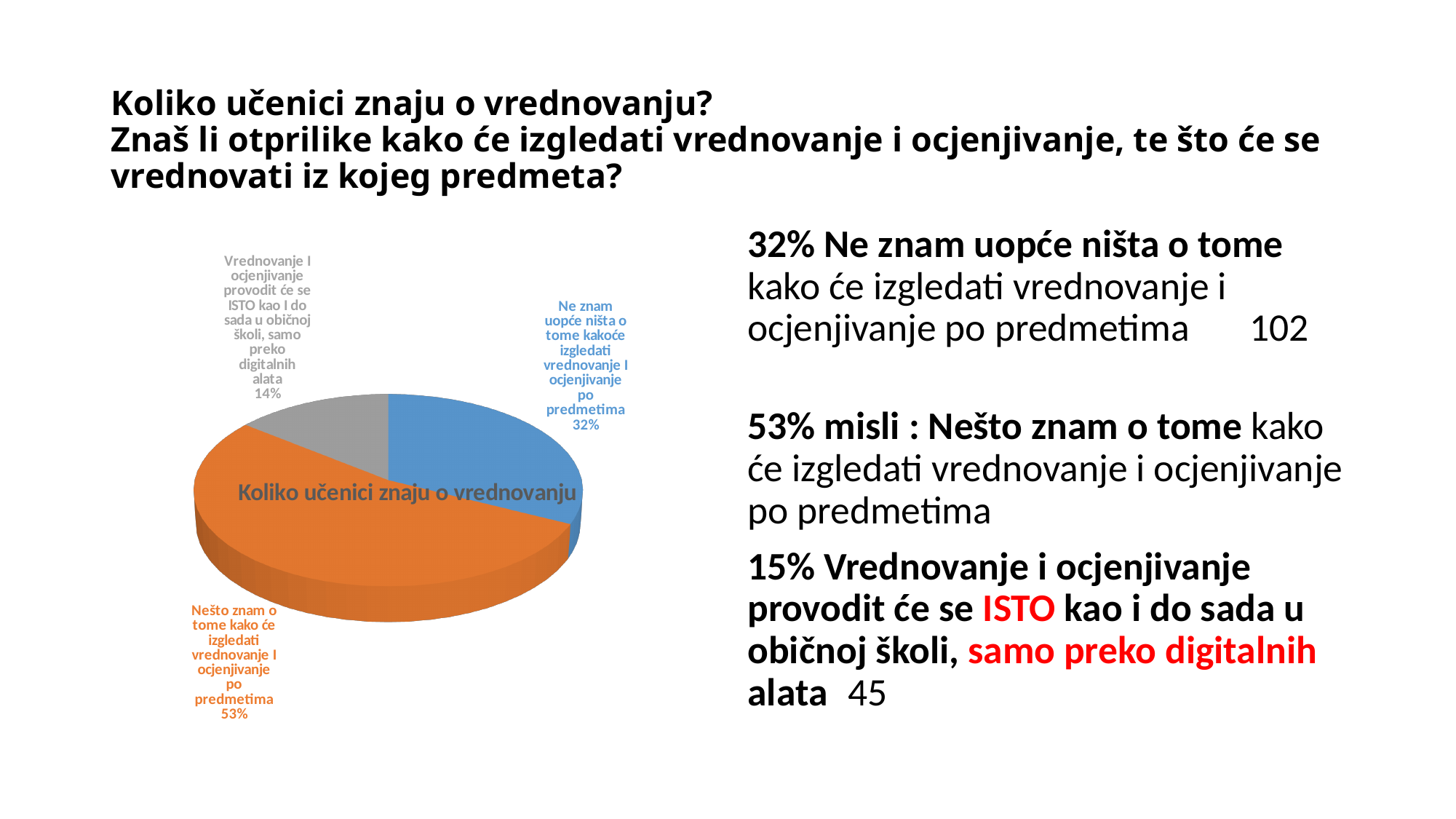
What is the title of the pie chart? Koliko učenici znaju o vrednovanju What share of the pie is labelled "Nešto znam o tome kako će izgledati vrednovanje I ocjenjivanje po predmetima"? 53% What share of the pie is labelled "Vrednovanje I ocjenjivanje provodit će se ISTO kao I do sada u običnoj školi, samo preko digitalnih alata"? 14% What colour is the slice labelled 53% in the pie chart? orange What kind of chart is shown on the slide? pie chart What share of the pie is labelled "Ne znam uopće ništa o tome kako će izgledati vrednovanje I ocjenjivanje po predmetima"? 32% What is the difference in percentage points between the "Ne znam uopće ništa" slice and the "Vrednovanje I ocjenjivanje provodit će se ISTO" slice? 18 Which slice of the pie chart is the smallest? Vrednovanje I ocjenjivanje provodit će se ISTO kao I do sada u običnoj školi, samo preko digitalnih alata Which is larger in the pie chart: the "Ne znam uopće ništa" slice or the "Vrednovanje I ocjenjivanje provodit će se ISTO" slice? Ne znam uopće ništa o tome kako će izgledati vrednovanje I ocjenjivanje po predmetima Which slice of the pie chart is the largest? Nešto znam o tome kako će izgledati vrednovanje I ocjenjivanje po predmetima How many slices does the pie chart have? 3 What is the difference in percentage points between the "Nešto znam" slice and the "Ne znam uopće ništa" slice? 21